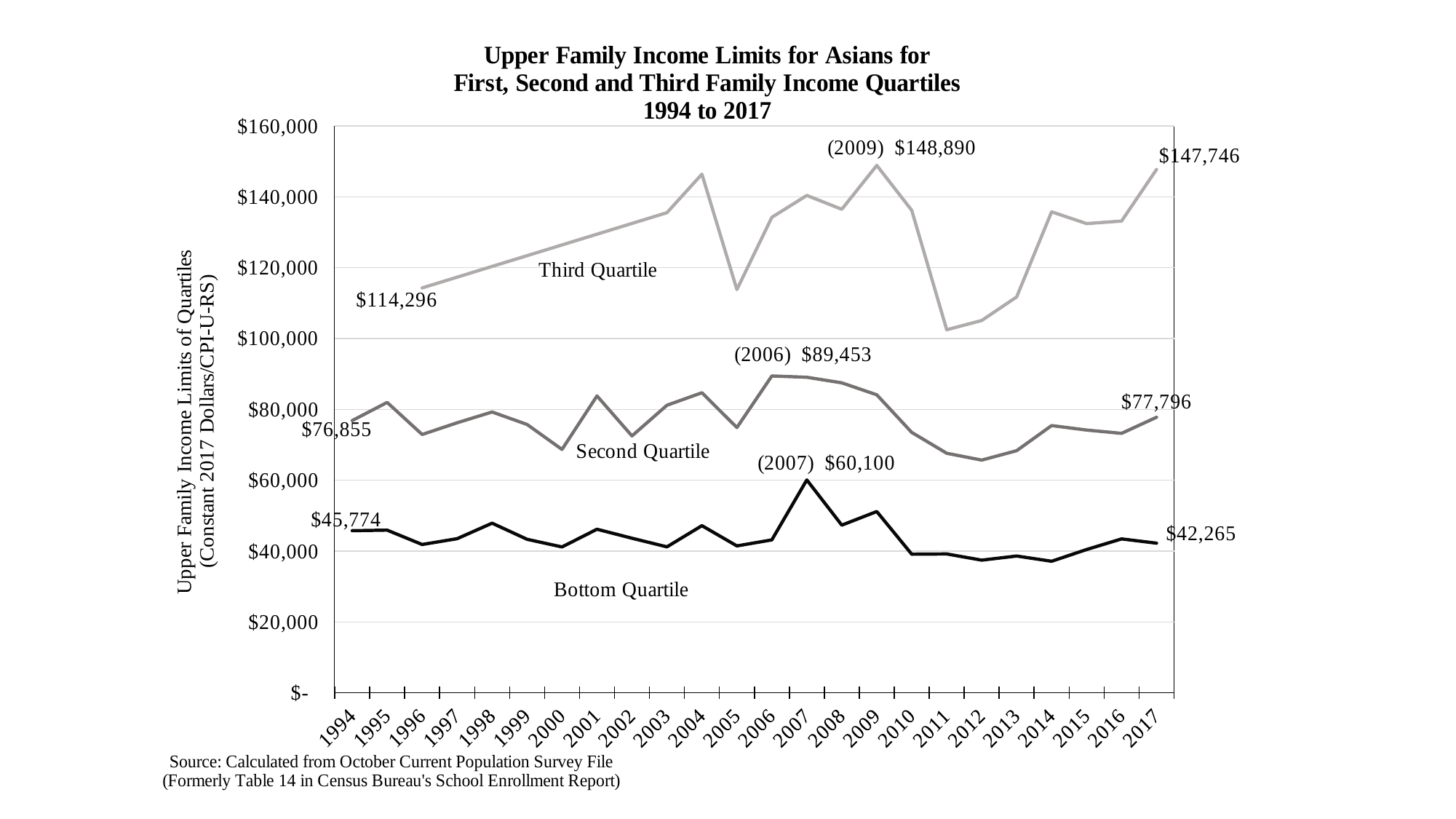
What is the Second Quartile value in 2006? $89,453 What is the Third Quartile value in 2009? $148,890 Which is larger for the Second Quartile: the 2006 value or the 2017 value? 2006 How much higher is the Third Quartile value in 2009 than in 2017? $1,144 What kind of chart is shown on the slide? line chart What is the Bottom Quartile value in 2007? $60,100 How many quartile lines are plotted on the chart? 3 What is the Third Quartile value in 2017? $147,746 What is the Bottom Quartile value in 2017? $42,265 In which year does the Bottom Quartile line reach its highest value? 2007 How much higher is the Bottom Quartile value in 2007 than in 2017? $17,835 Is the Third Quartile value in 2011 greater or less than $120,000? less